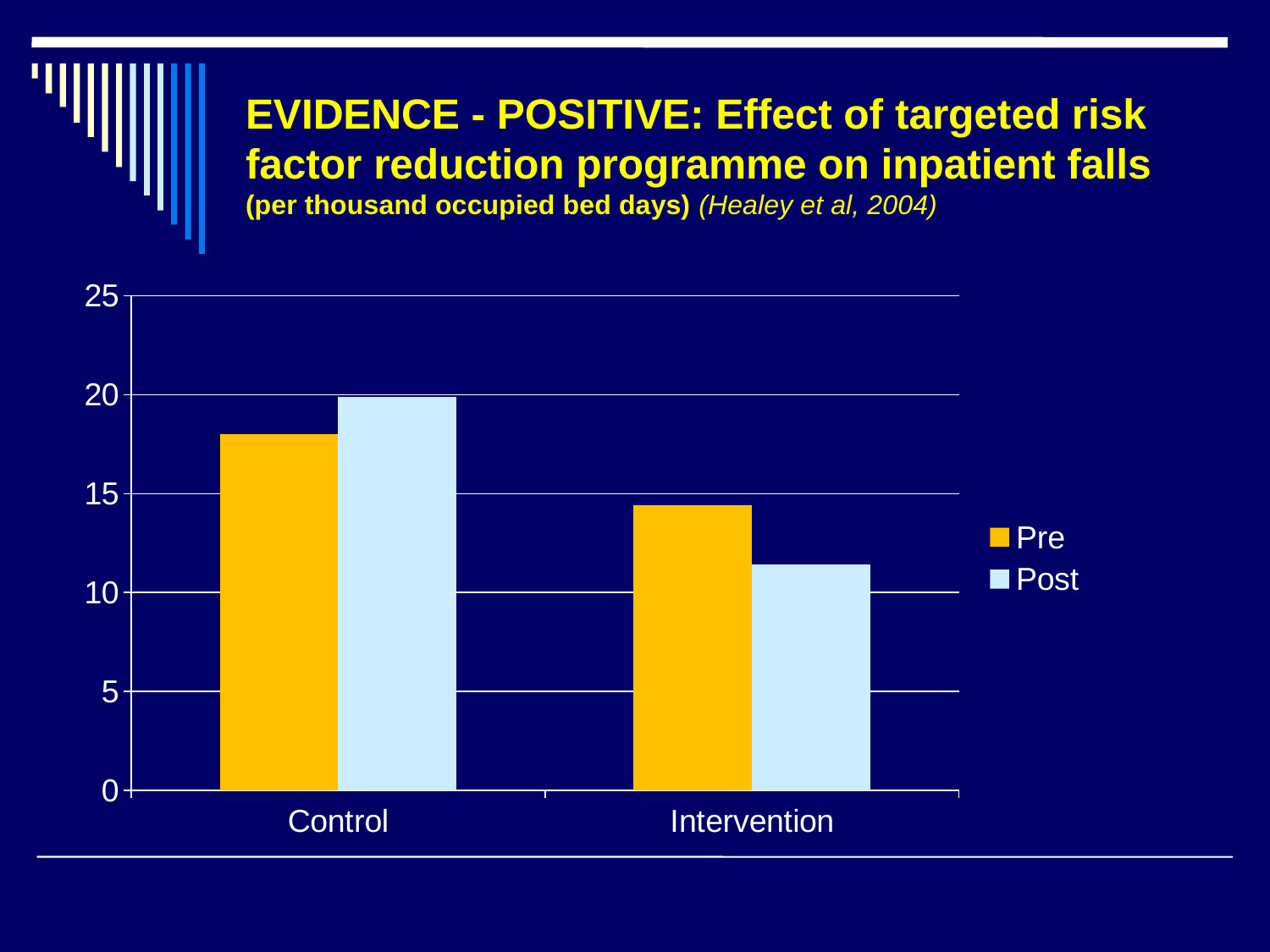
For Control, which is larger, the Pre value or the Post value? Post Is the Post value for Intervention greater or less than 10? greater How many categories are shown on the x axis? 2 Is the Pre value for Intervention greater or less than 10? greater What kind of chart is shown on the slide? bar chart For Intervention, which is larger, the Pre value or the Post value? Pre Which category has the lowest Post value? Intervention How many series does the legend list? 2 Which series is shown in light blue? Post Is the Post value for Intervention greater or less than 15? less